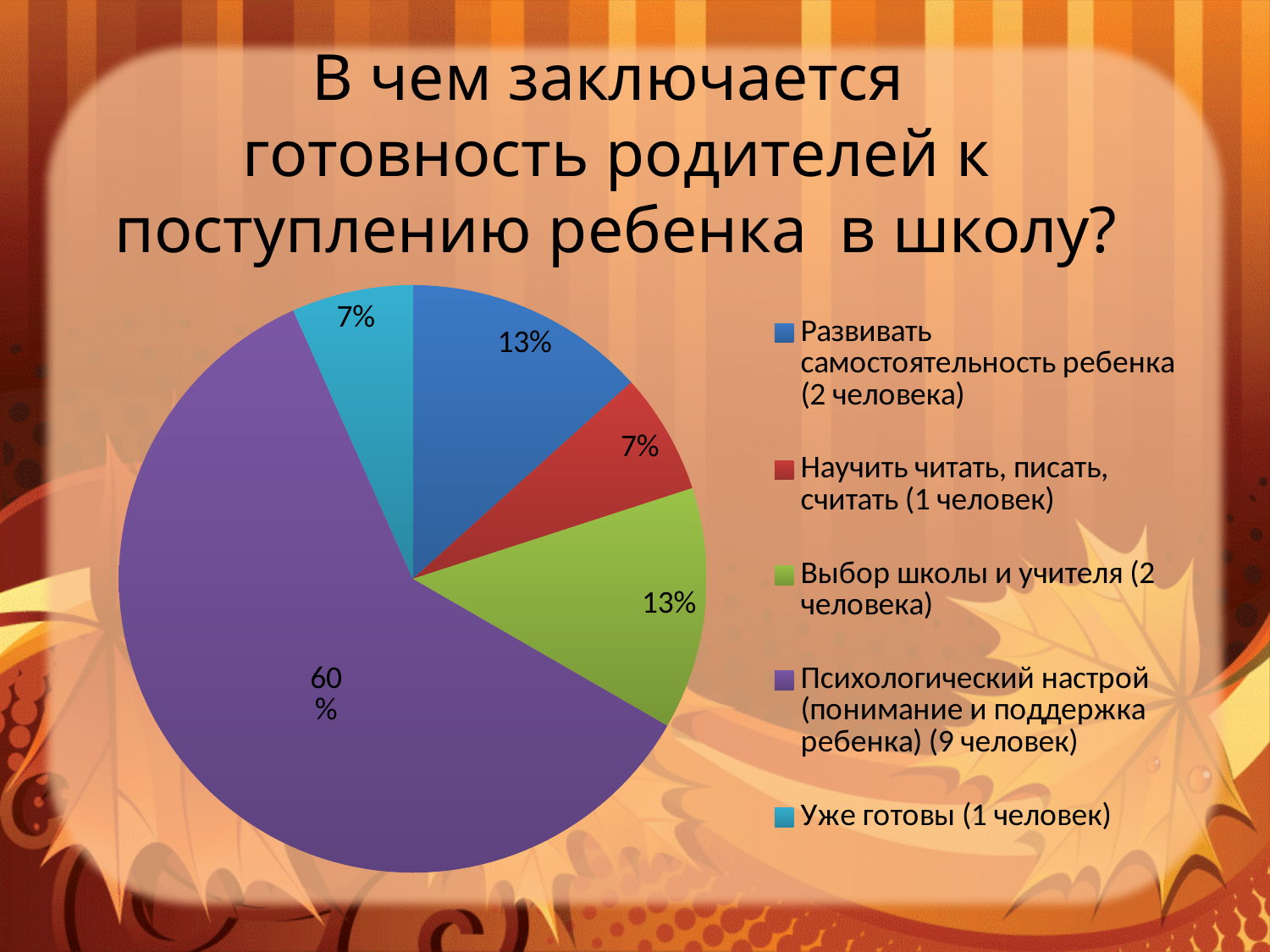
Which is larger: the share for "Развивать самостоятельность ребенка (2 человека)" or the share for "Уже готовы (1 человек)"? Развивать самостоятельность ребенка (2 человека) What share of the pie does "Психологический настрой (понимание и поддержка ребенка) (9 человек)" take? 60% What kind of chart is shown on the slide? pie chart What colour is the slice for "Психологический настрой (понимание и поддержка ребенка) (9 человек)"? purple What is the difference in percentage points between "Психологический настрой (понимание и поддержка ребенка) (9 человек)" and "Выбор школы и учителя (2 человека)"? 47 What percentage is shown for "Научить читать, писать, считать (1 человек)"? 7% What percentage is shown for "Развивать самостоятельность ребенка (2 человека)"? 13% How many slices does the pie chart have? 5 Which category has the largest share of the pie? Психологический настрой (понимание и поддержка ребенка) (9 человек) What is the title of the slide? В чем заключается готовность родителей к поступлению ребенка в школу? What percentage is shown for "Уже готовы (1 человек)"? 7% What percentage is shown for "Выбор школы и учителя (2 человека)"? 13%